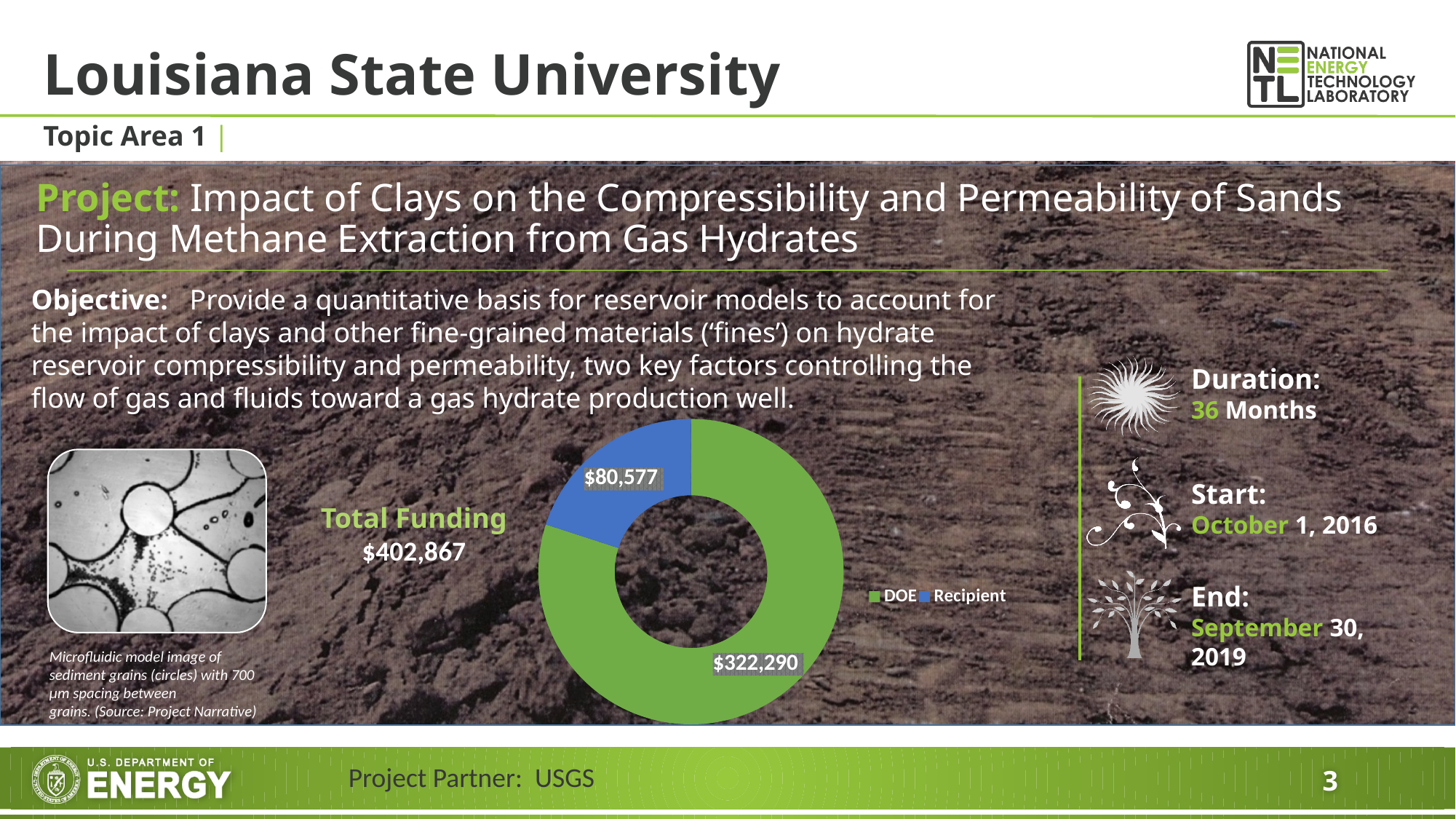
What kind of chart is shown on the slide? Pie chart (donut) What is the difference between the DOE and Recipient funding amounts? $241,713 What is the DOE funding amount shown on the chart? $322,290 Which category has the largest slice in the chart? DOE How many categories does the chart legend list? 2 What colour is the DOE slice in the chart? Green Which category has the smallest slice in the chart? Recipient What is the Recipient funding amount shown on the chart? $80,577 Which funding source has the larger slice, DOE or Recipient? DOE What is the total funding shown next to the chart? $402,867